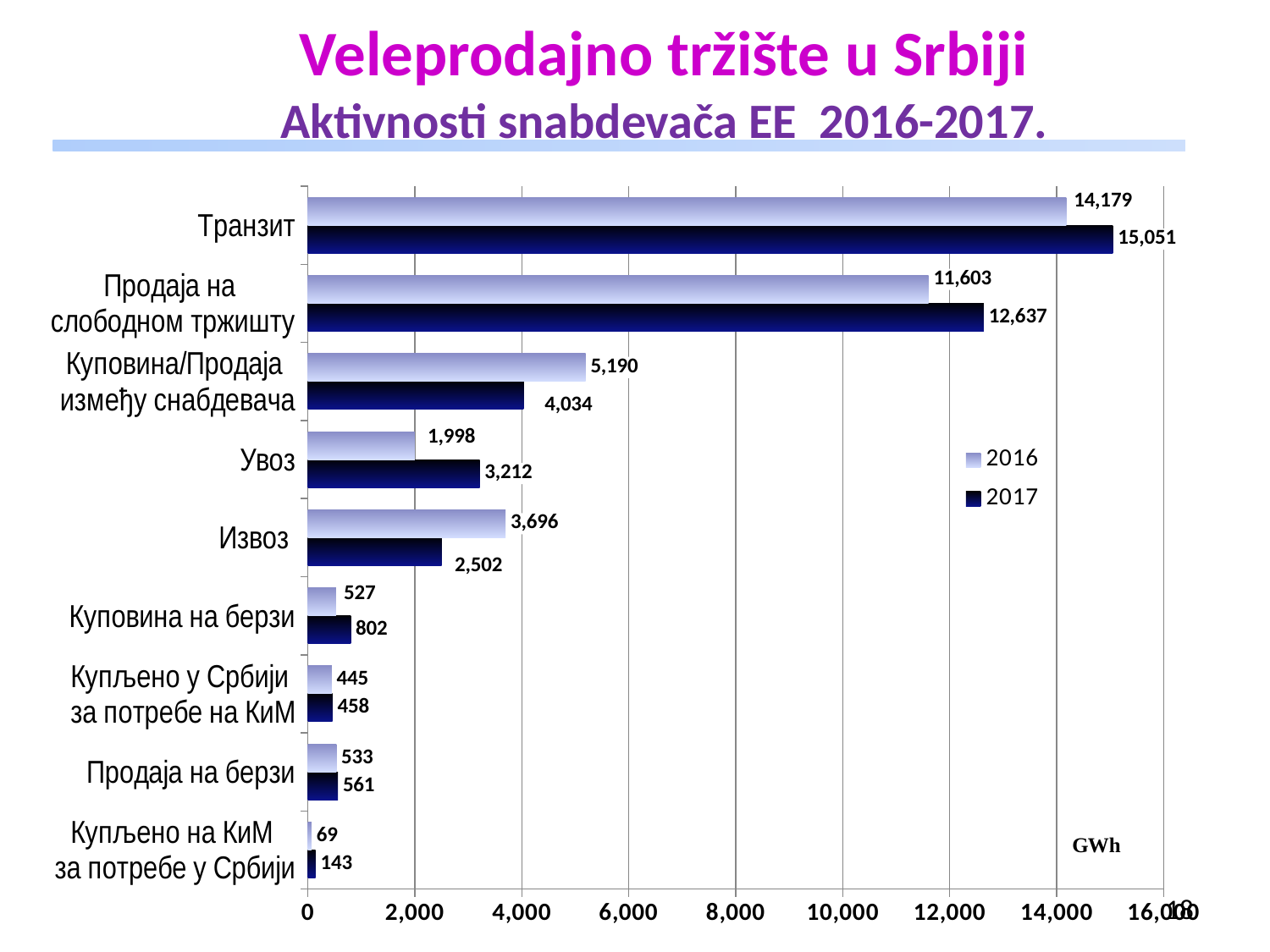
How many series does the legend list? 2 What unit is indicated on the chart? GWh Which category has the lowest 2017 value? Купљено на КиМ за потребе у Србији What kind of chart is shown on the slide? Bar chart What is the 2016 value for Увоз? 1,998 What is the 2017 value for Транзит? 15,051 For Извоз, which year has the larger value, 2016 or 2017? 2016 What is the 2017 value for Куповина на берзи? 802 For Куповина/Продаја између снабдевача, which year has the larger value, 2016 or 2017? 2016 Which category has the highest 2016 value? Транзит How many categories are shown on the chart? 9 What is the difference between the 2017 and 2016 values for Продаја на слободном тржишту? 1,034